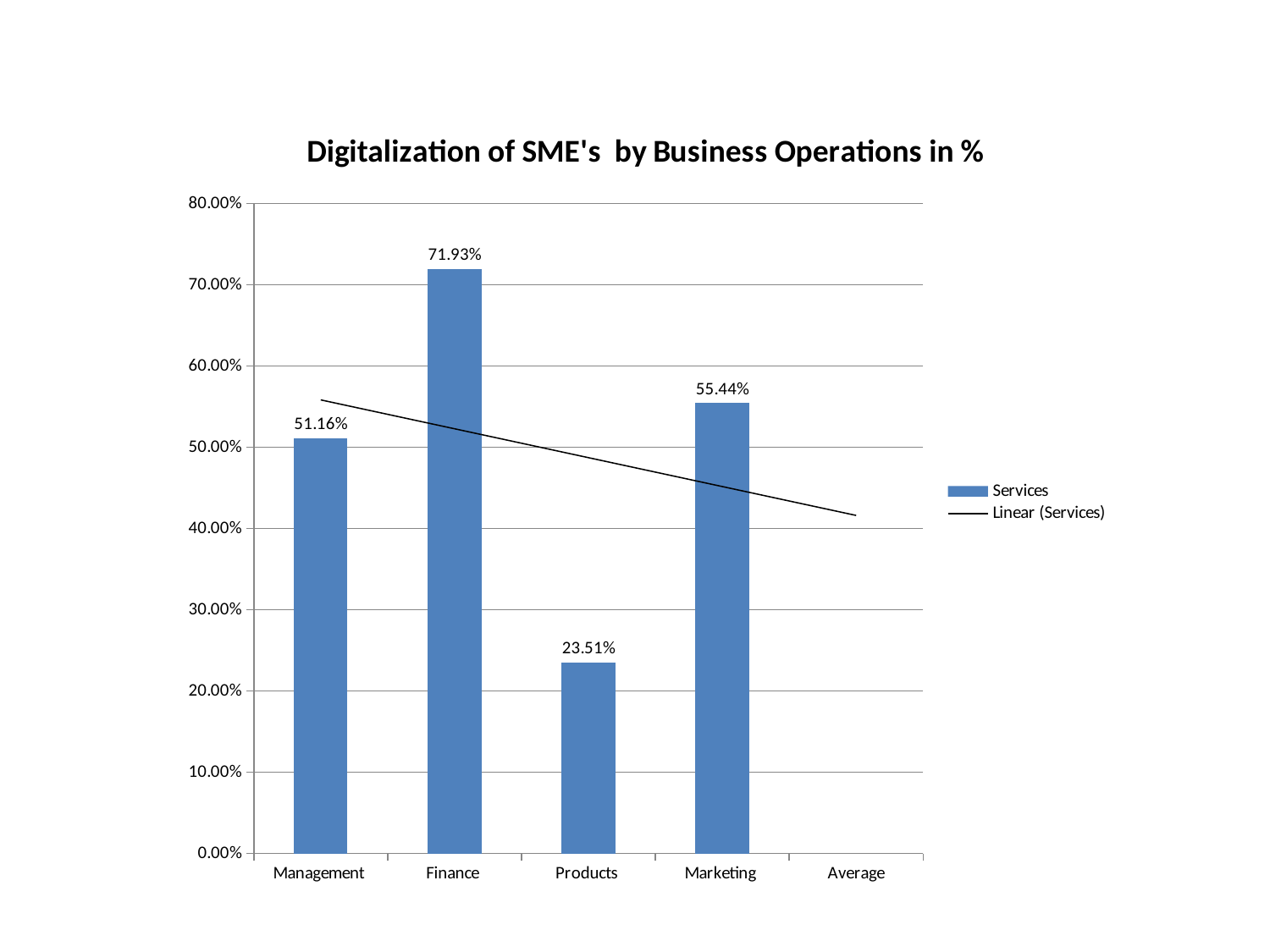
What is the value for Finance? 71.93% What kind of chart is shown on the slide? bar chart Which category has the lowest value? Products Which category has the highest value? Finance How many bars are plotted on the chart? 4 Does the linear trendline rise or fall from left to right? fall What is the difference between the values for Finance and Management? 20.77% What is the difference between the values for Marketing and Products? 31.93% What is the value for Products? 23.51% Is the value for Products greater or less than 30.00%? less Which is larger, the value for Marketing or the value for Management? Marketing What is the value for Management? 51.16%